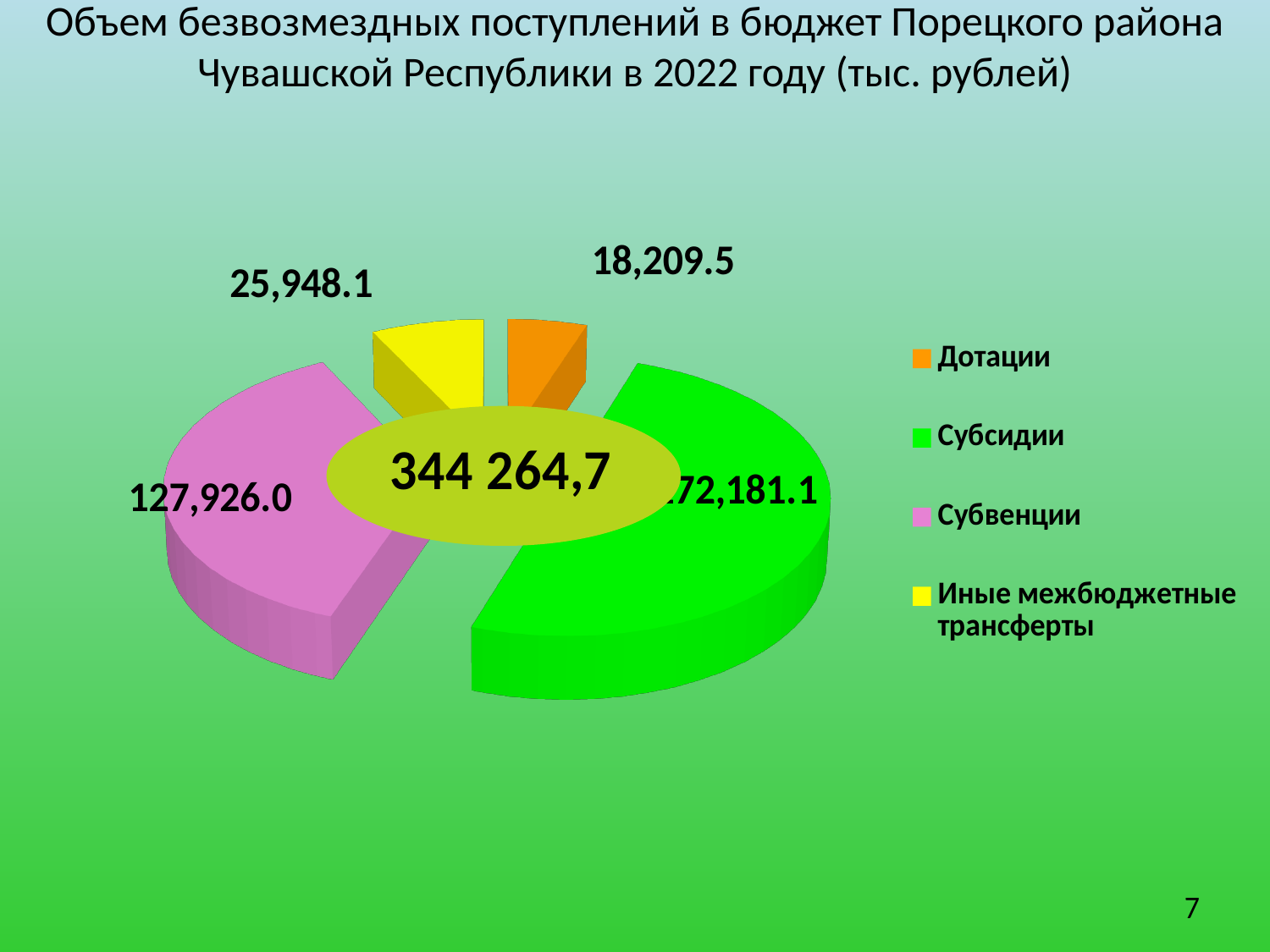
Which is larger, the value for Субвенции or the value for Иные межбюджетные трансферты? Субвенции What is the difference between the values for Субвенции and Иные межбюджетные трансферты? 101,977.9 What colour is the Субвенции slice in the pie chart? Pink What is the value for Иные межбюджетные трансферты on the pie chart? 25,948.1 What kind of chart is shown on the slide? Pie chart How many categories are shown in the pie chart? 4 Which category has the largest slice of the pie chart? Субсидии Which category has the smallest slice of the pie chart? Дотации What total value is printed in the centre of the pie chart? 344 264,7 What is the value for Дотации on the pie chart? 18,209.5 What is the difference between the values for Иные межбюджетные трансферты and Дотации? 7,738.6 What is the value for Субвенции on the pie chart? 127,926.0